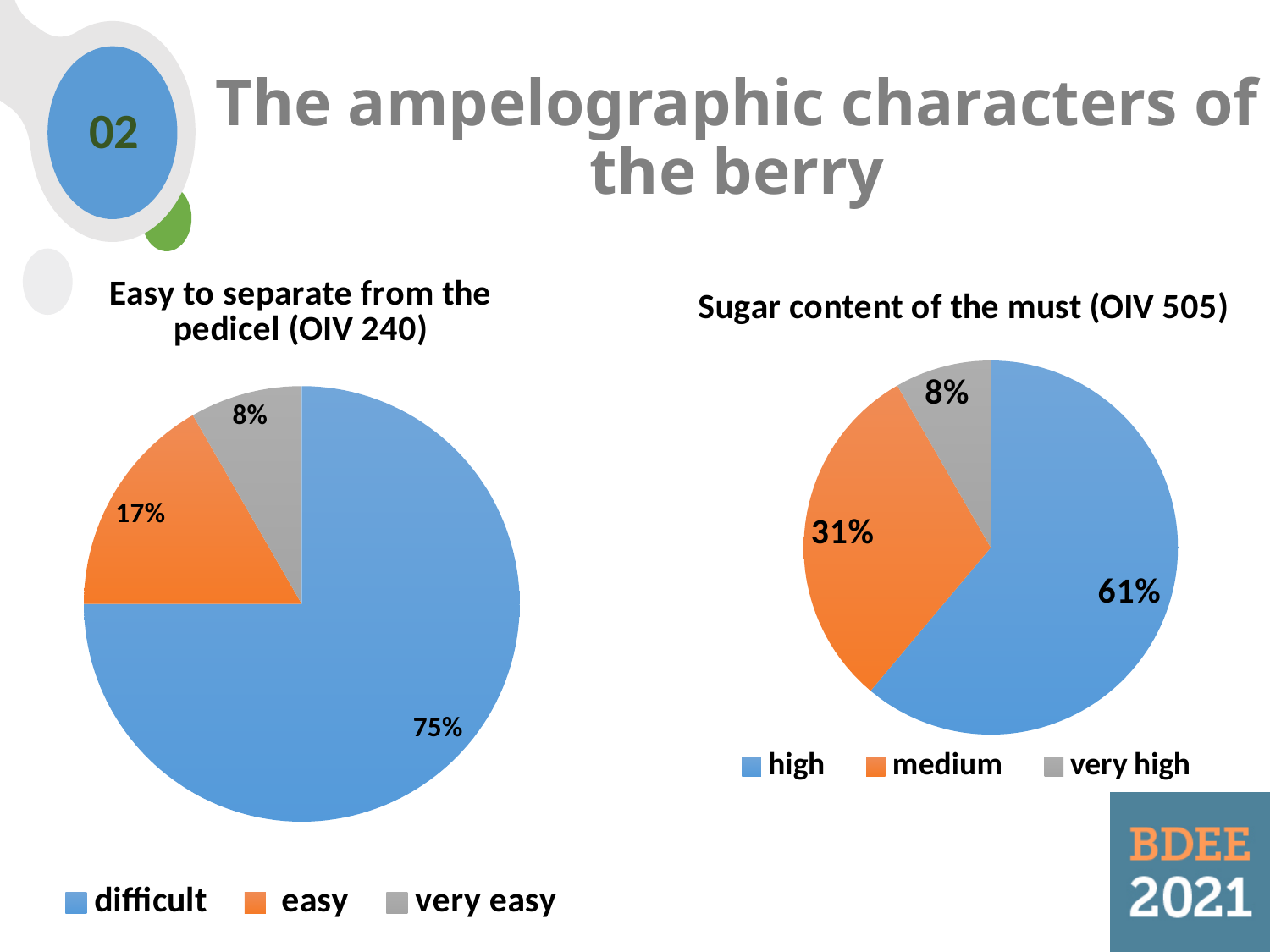
In the 'Sugar content of the must (OIV 505)' chart, which category has the smallest slice? very high In the 'Easy to separate from the pedicel (OIV 240)' chart, how many categories does the legend list? 3 What type of chart is the 'Sugar content of the must (OIV 505)' chart? pie chart In the 'Easy to separate from the pedicel (OIV 240)' chart, which category has the largest slice? difficult In the 'Sugar content of the must (OIV 505)' chart, what is the difference between the 'high' and 'medium' slices? 30% In the 'Easy to separate from the pedicel (OIV 240)' chart, what is the difference between the 'difficult' and 'easy' slices? 58% In the 'Easy to separate from the pedicel (OIV 240)' chart, what share of the pie is labelled 'difficult'? 75% In the 'Sugar content of the must (OIV 505)' chart, what is the value for 'medium'? 31% In the 'Easy to separate from the pedicel (OIV 240)' chart, what is the value for 'very easy'? 8% In the 'Sugar content of the must (OIV 505)' chart, what is the value for 'high'? 61% In the 'Sugar content of the must (OIV 505)' chart, which is larger, 'medium' or 'very high'? medium In the 'Easy to separate from the pedicel (OIV 240)' chart, what is the value for 'easy'? 17%